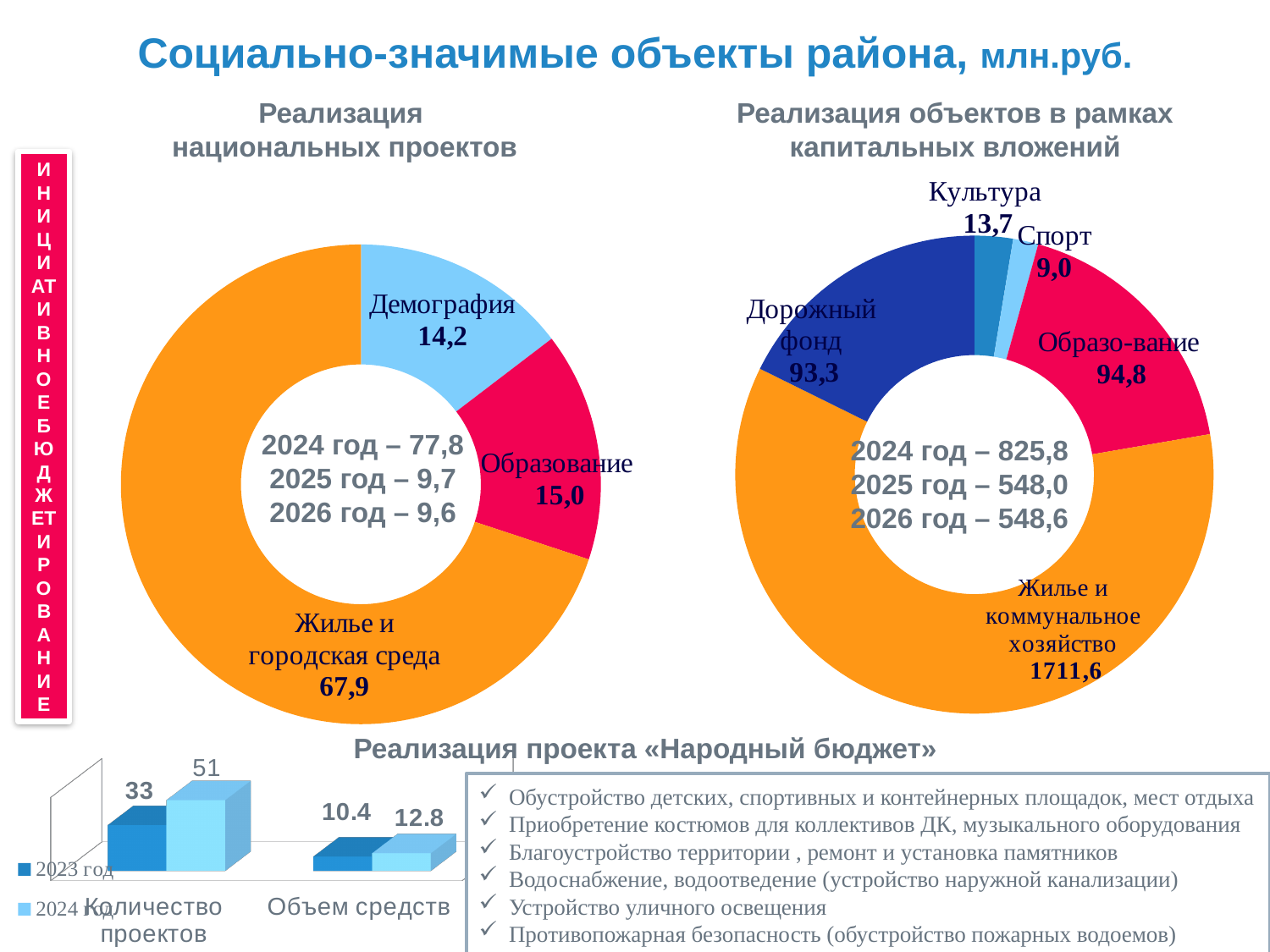
In the chart 'Реализация объектов в рамках капитальных вложений', what is the value for Дорожный фонд? 93,3 In the chart 'Реализация объектов в рамках капитальных вложений', which is larger: Образование or Дорожный фонд? Образование In the chart 'Реализация проекта «Народный бюджет»', what is the difference between 2024 год and 2023 год for Объем средств? 2.4 In the chart 'Реализация проекта «Народный бюджет»', what is the value for Количество проектов in 2024 год? 51 How many categories are shown in the chart 'Реализация объектов в рамках капитальных вложений'? 5 What kind of chart is 'Реализация проекта «Народный бюджет»'? Bar chart In the chart 'Реализация объектов в рамках капитальных вложений', which category has the smallest value? Спорт How many categories are shown in the chart 'Реализация национальных проектов'? 3 In the chart 'Реализация национальных проектов', which category has the largest value? Жилье и городская среда How many series does the legend of the chart 'Реализация проекта «Народный бюджет»' list? 2 In the chart 'Реализация национальных проектов', what is the value for Демография? 14,2 In the chart 'Реализация национальных проектов', what is the difference between Образование and Демография? 0,8